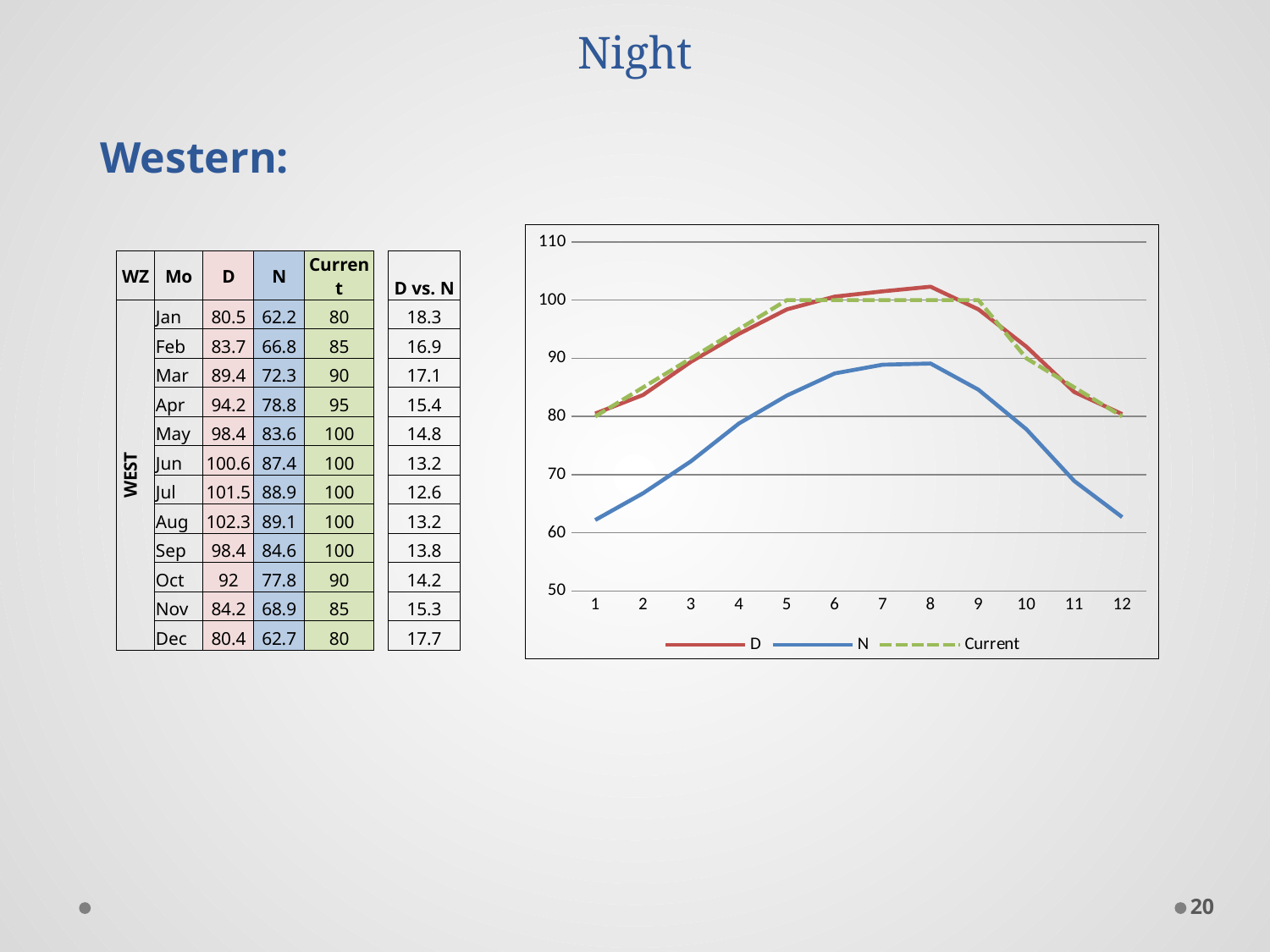
What kind of chart is shown on the slide? line chart How many points are plotted along the x axis of the chart? 12 According to the table on the slide, what is the Current value for Apr (x = 4)? 95 How many series does the chart legend list? 3 According to the table on the slide, what is the D value for Jan (x = 1)? 80.5 According to the table on the slide, what is the difference between D and N for Jan (D vs. N)? 18.3 At x = 12, which series has the larger value, D or N? D Which series in the chart is drawn with a dashed line? Current Is the value of the N series at x = 6 greater or less than 80? greater Is the value of the D series at x = 4 greater or less than 90? greater Is the value of the N series at x = 12 greater or less than 70? less Does the N series rise or fall from x = 1 to x = 8? rise